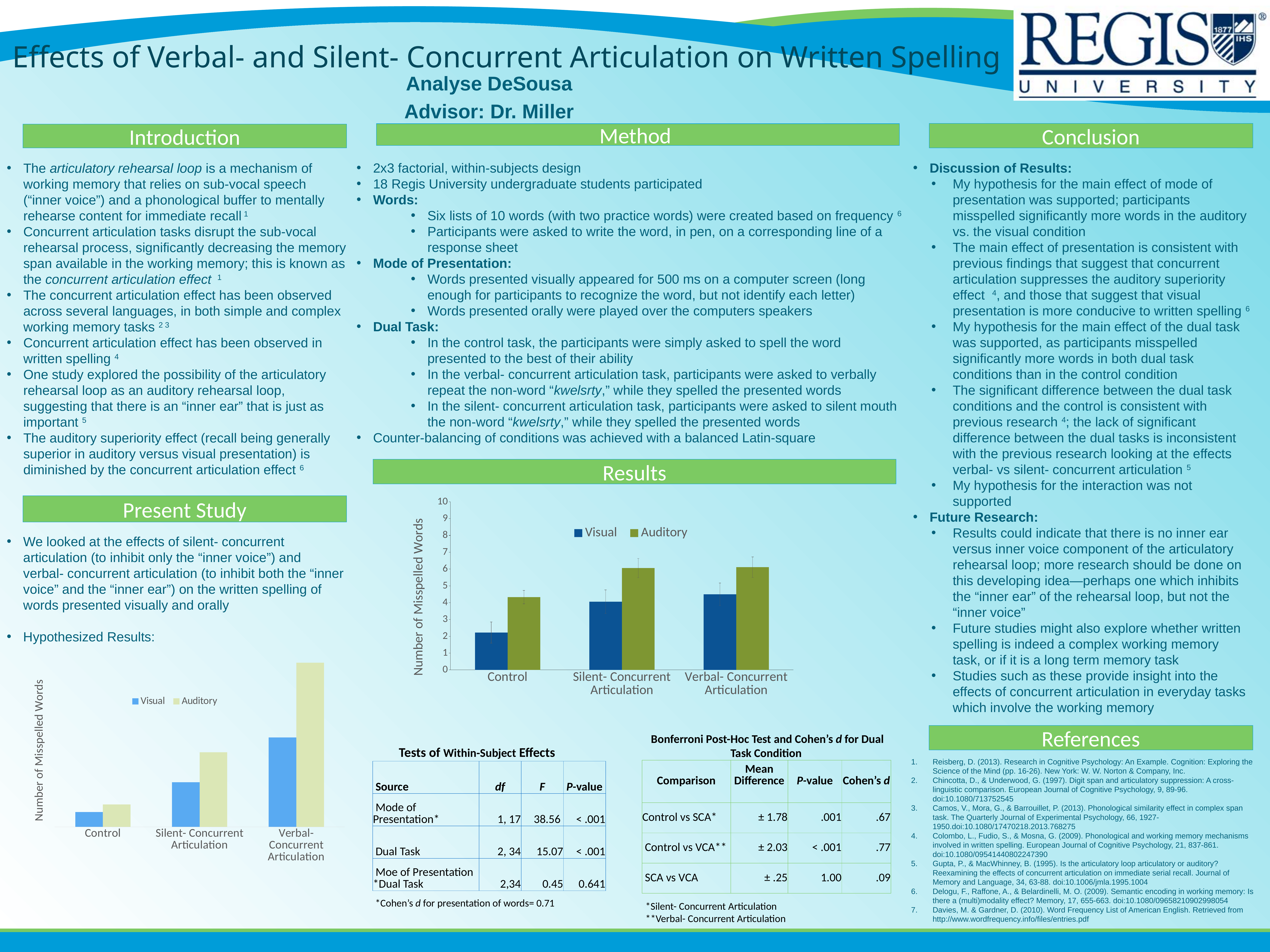
In the Hypothesized Results chart in the Present Study section, which bar is the highest? Auditory, Verbal- Concurrent Articulation In the Results chart, which series has the larger value for Control, Visual or Auditory? Auditory In the Results chart, how many series does the legend list? 2 What kind of chart is shown in the Results section? bar chart In the Results chart, is the Auditory value for Silent- Concurrent Articulation greater or less than 5? greater In the Results chart, do the Visual values rise or fall from Control to Verbal- Concurrent Articulation? rise In the Results chart, is the Visual value for Control greater or less than 3? less In the Results chart, which bar is the lowest? Visual, Control In the Results chart, is the Auditory value for Control greater or less than 5? less In the Results chart, how many categories are shown on the x axis? 3 What is the y-axis label of the Results chart? Number of Misspelled Words In the Hypothesized Results chart in the Present Study section, which series has the larger value for Silent- Concurrent Articulation, Visual or Auditory? Auditory